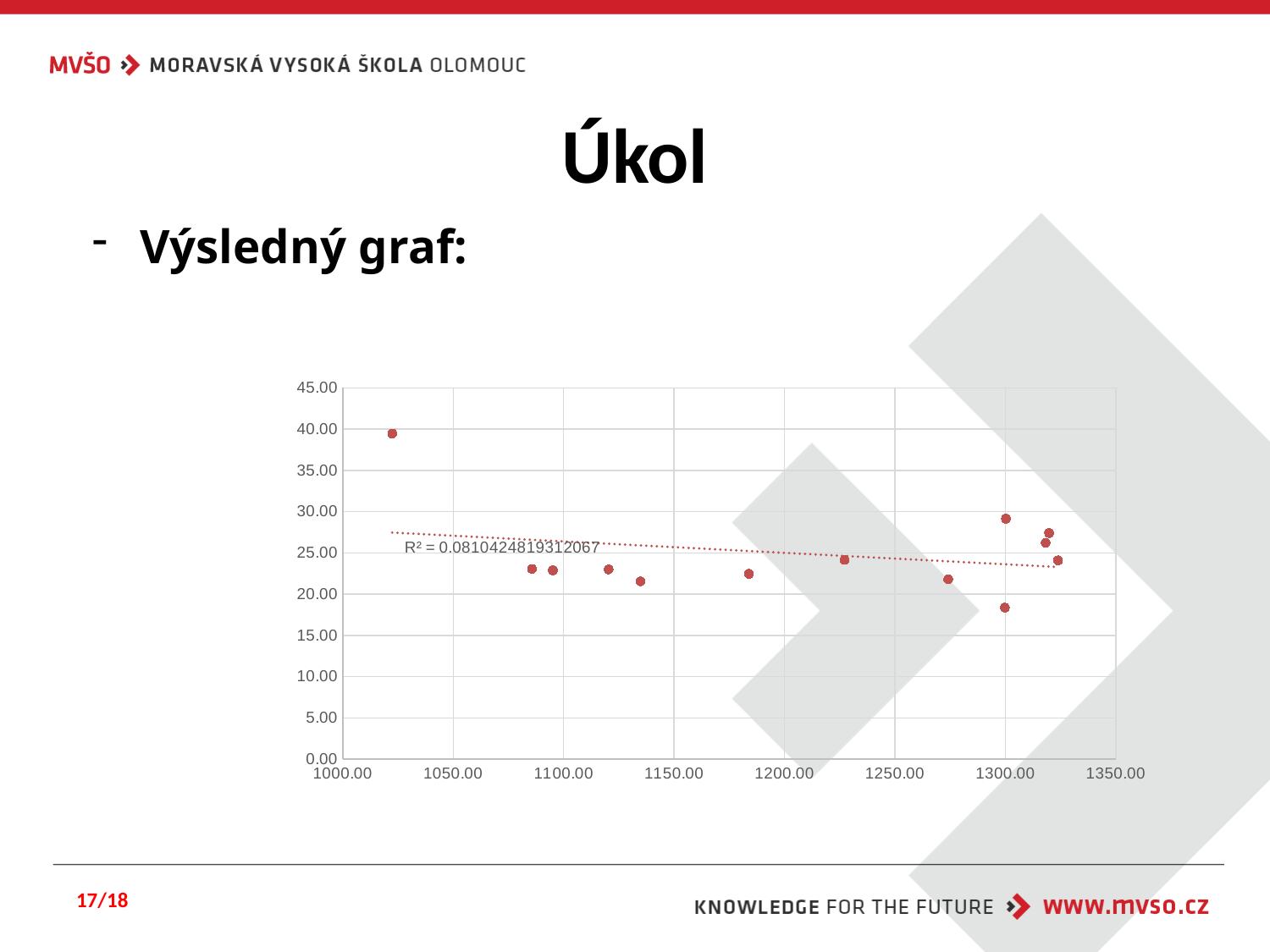
Which point has the highest y value: the leftmost point near x = 1000 or the point near x = 1300 at about 30? the leftmost point near x = 1000 What R² value is printed on the chart? R² = 0.0810424819312067 Is the y value of the highest point (the leftmost point, near x = 1000) greater or less than 35.00? greater Is the y value of the lowest point (near x = 1300) greater or less than 20.00? less Is the y value of the point near x = 1150 greater or less than 25.00? less What is the highest value shown on the y axis? 45.00 What kind of chart is shown on the slide? scatter chart What is the highest value shown on the x axis? 1350.00 Does the dotted trendline rise or fall as the x values increase? fall